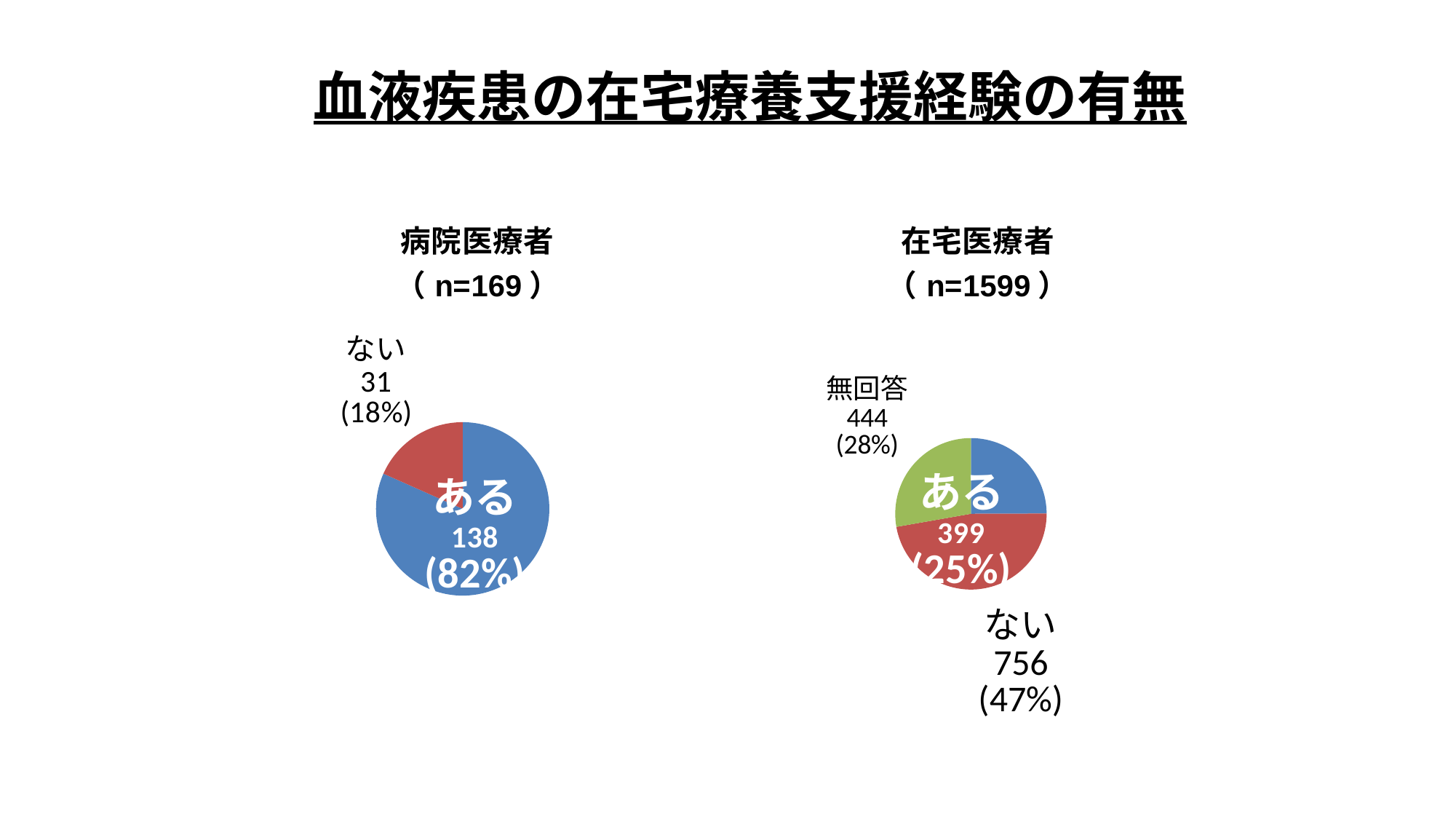
How many slices does the 在宅医療者 (n=1599) pie chart have? 3 In the 病院医療者 (n=169) chart, what is the difference between the ある and ない counts? 107 In the 在宅医療者 (n=1599) chart, what percentage share does ない have? 47% What is the title of the slide containing the two pie charts? 血液疾患の在宅療養支援経験の有無 What type of chart is used for the 病院医療者 (n=169) data? pie chart In the 在宅医療者 (n=1599) chart, which is larger, 無回答 or ある? 無回答 In the 病院医療者 (n=169) chart, what percentage share does ない have? 18% In the 在宅医療者 (n=1599) chart, which category has the smallest slice? ある How many slices does the 病院医療者 (n=169) pie chart have? 2 In the 病院医療者 (n=169) chart, what is the value for ある? 138 In the 在宅医療者 (n=1599) chart, what is the value for 無回答? 444 In the 在宅医療者 (n=1599) chart, which category has the largest slice? ない